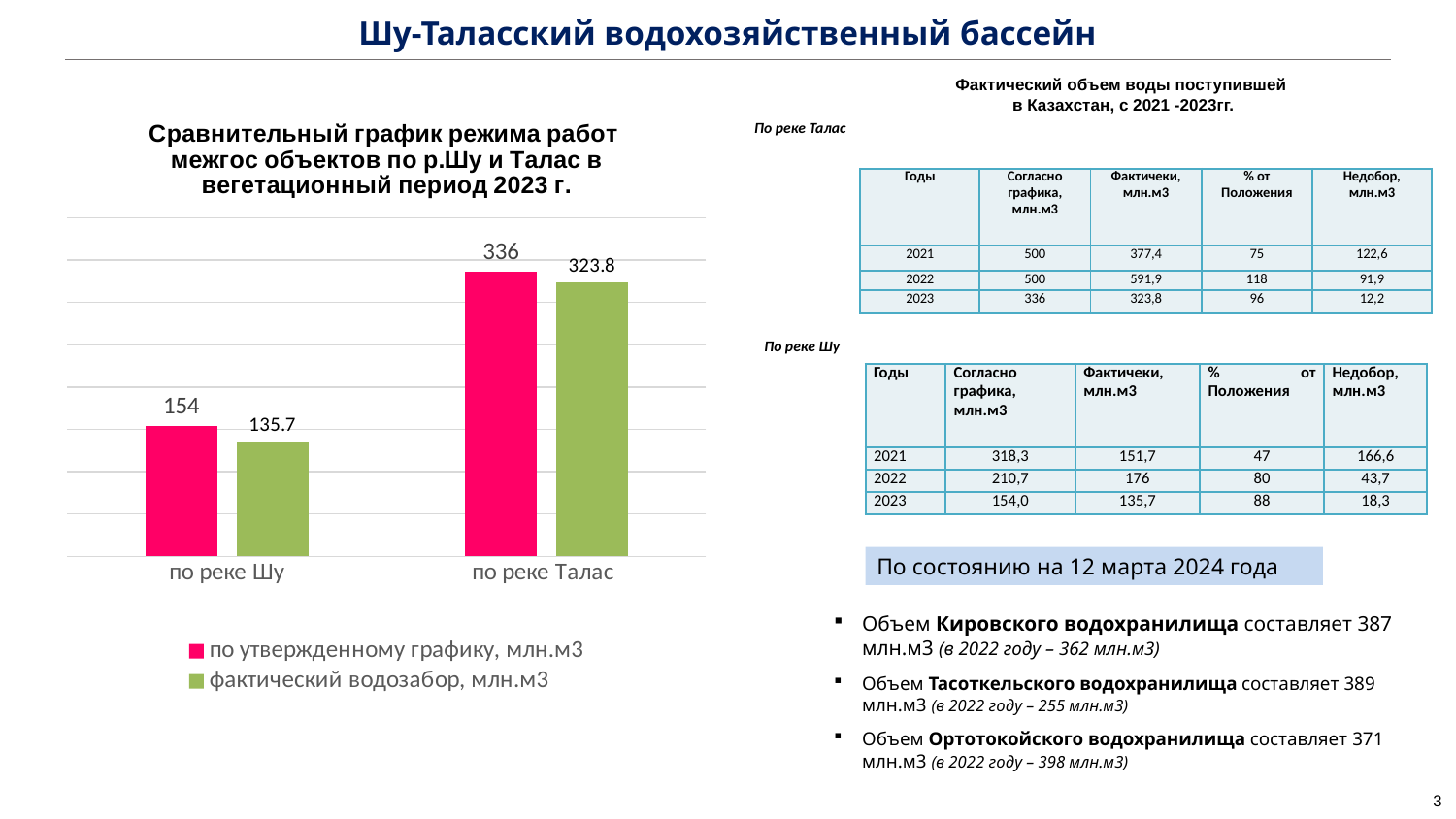
What kind of chart is shown on the slide? bar chart What is the value for 'по утвержденному графику, млн.м3' for 'по реке Талас'? 336 What is the value for 'фактический водозабор, млн.м3' for 'по реке Талас'? 323.8 For 'по реке Талас', which is larger: 'по утвержденному графику, млн.м3' or 'фактический водозабор, млн.м3'? по утвержденному графику, млн.м3 How many series does the chart legend list? 2 Which category has the lowest value for 'фактический водозабор, млн.м3'? по реке Шу What is the value for 'фактический водозабор, млн.м3' for 'по реке Шу'? 135.7 What is the value for 'по утвержденному графику, млн.м3' for 'по реке Шу'? 154 How many categories are shown on the x axis of the chart? 2 What is the difference between 'по утвержденному графику, млн.м3' and 'фактический водозабор, млн.м3' for 'по реке Талас'? 12.2 What is the difference between 'по утвержденному графику, млн.м3' and 'фактический водозабор, млн.м3' for 'по реке Шу'? 18.3 Which category has the highest value for 'по утвержденному графику, млн.м3'? по реке Талас